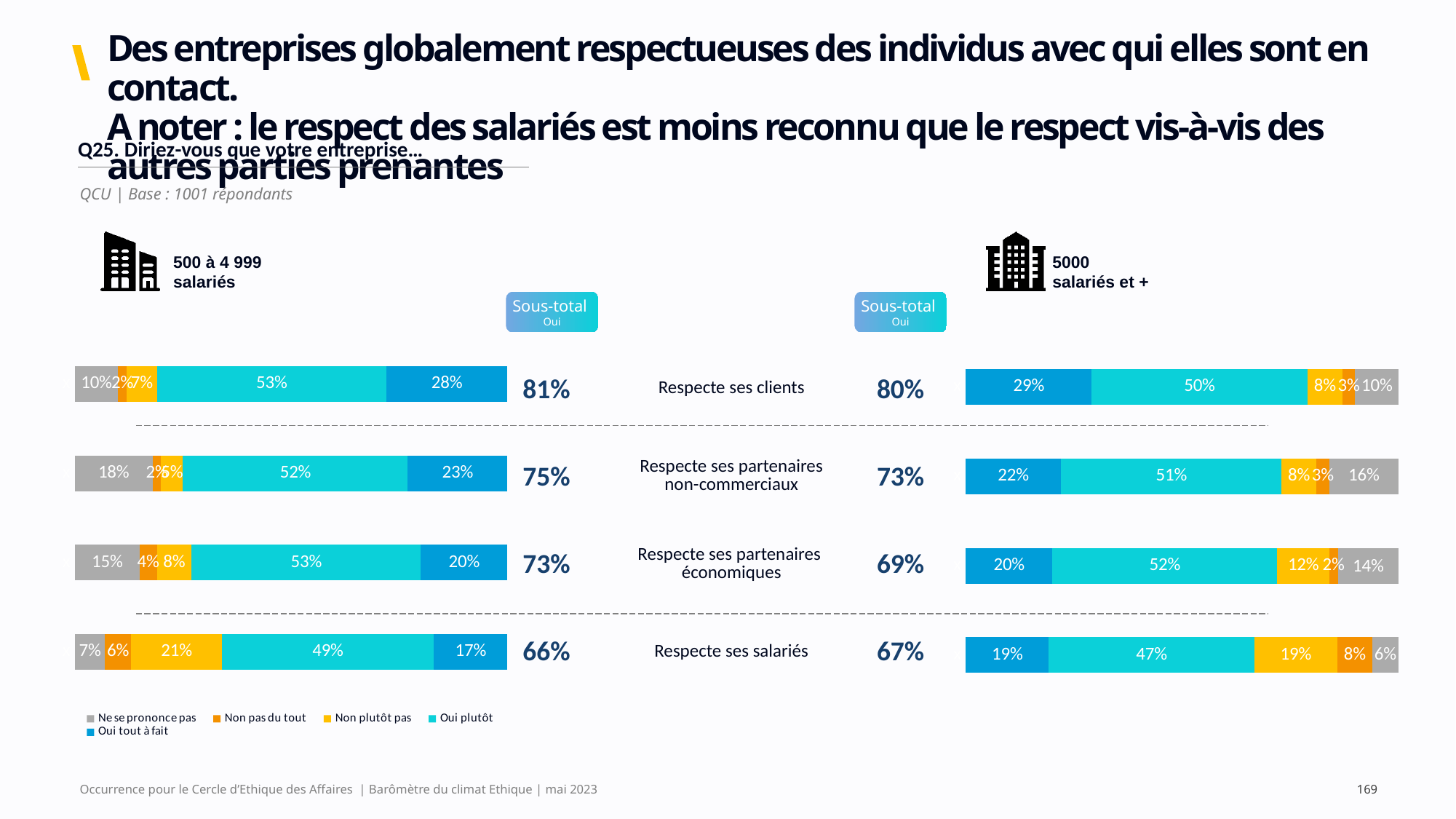
In the chart for companies with 5000 salariés et +, which is larger: the 'Non plutôt pas' value for 'Respecte ses salariés' or for 'Respecte ses clients'? Respecte ses salariés How many items (rows) are shown in the chart for companies with 500 à 4 999 salariés? 4 How many series does the legend list? 5 In the chart for companies with 500 à 4 999 salariés, which item has the highest 'Oui tout à fait' value? Respecte ses clients In the chart for companies with 5000 salariés et +, what is the 'Oui plutôt' value for 'Respecte ses partenaires économiques'? 52% In the chart for companies with 500 à 4 999 salariés, what is the 'Oui tout à fait' value for 'Respecte ses clients'? 28% In the chart for companies with 500 à 4 999 salariés, what is the 'Non plutôt pas' value for 'Respecte ses salariés'? 21% In the chart for companies with 5000 salariés et +, which item has the lowest 'Oui tout à fait' value? Respecte ses salariés What is the 'Sous-total Oui' for 'Respecte ses salariés' in the chart for companies with 5000 salariés et +? 67% In the chart for companies with 500 à 4 999 salariés, what is the difference between the 'Oui plutôt' values for 'Respecte ses clients' and 'Respecte ses salariés'? 4 percentage points In the chart for companies with 5000 salariés et +, what is the 'Ne se prononce pas' value for 'Respecte ses partenaires non-commerciaux'? 16% What kind of chart is used for the 5000 salariés et + data? Stacked bar chart